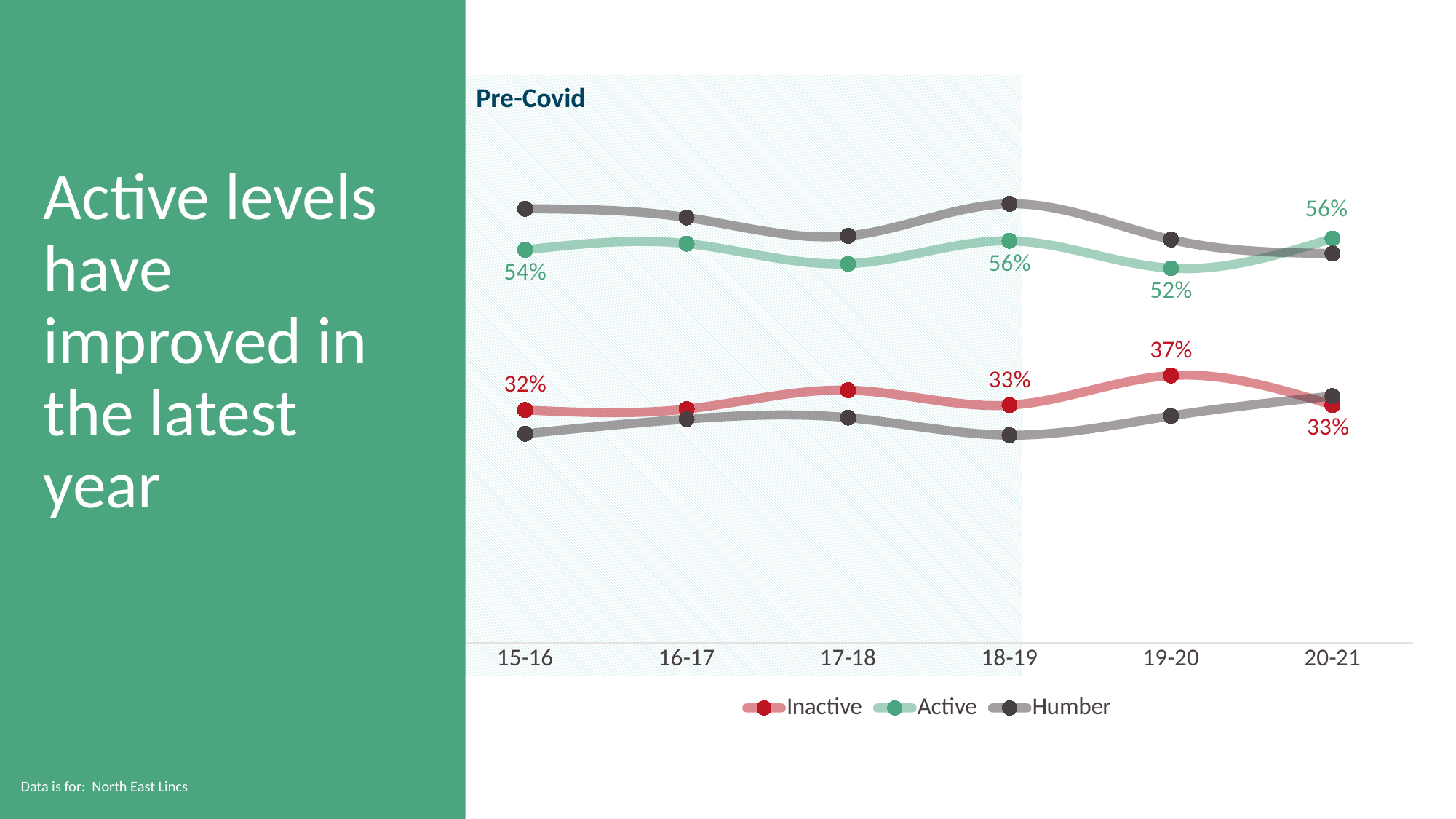
How many years are shown on the x axis? 6 What is the value of the Inactive series in 20-21? 33% What kind of chart is shown on the slide? Line chart What is the difference between the Inactive values in 19-20 and 18-19? 4% Which year has the higher Active value, 15-16 or 20-21? 20-21 What is the value of the Inactive series in 19-20? 37% What is the value of the Active series in 19-20? 52% In which year is the Inactive series at its highest? 19-20 How many series does the legend list? 3 By how much did the Active value change from 19-20 to 20-21? 4% What is the value of the Active series in 15-16? 54%